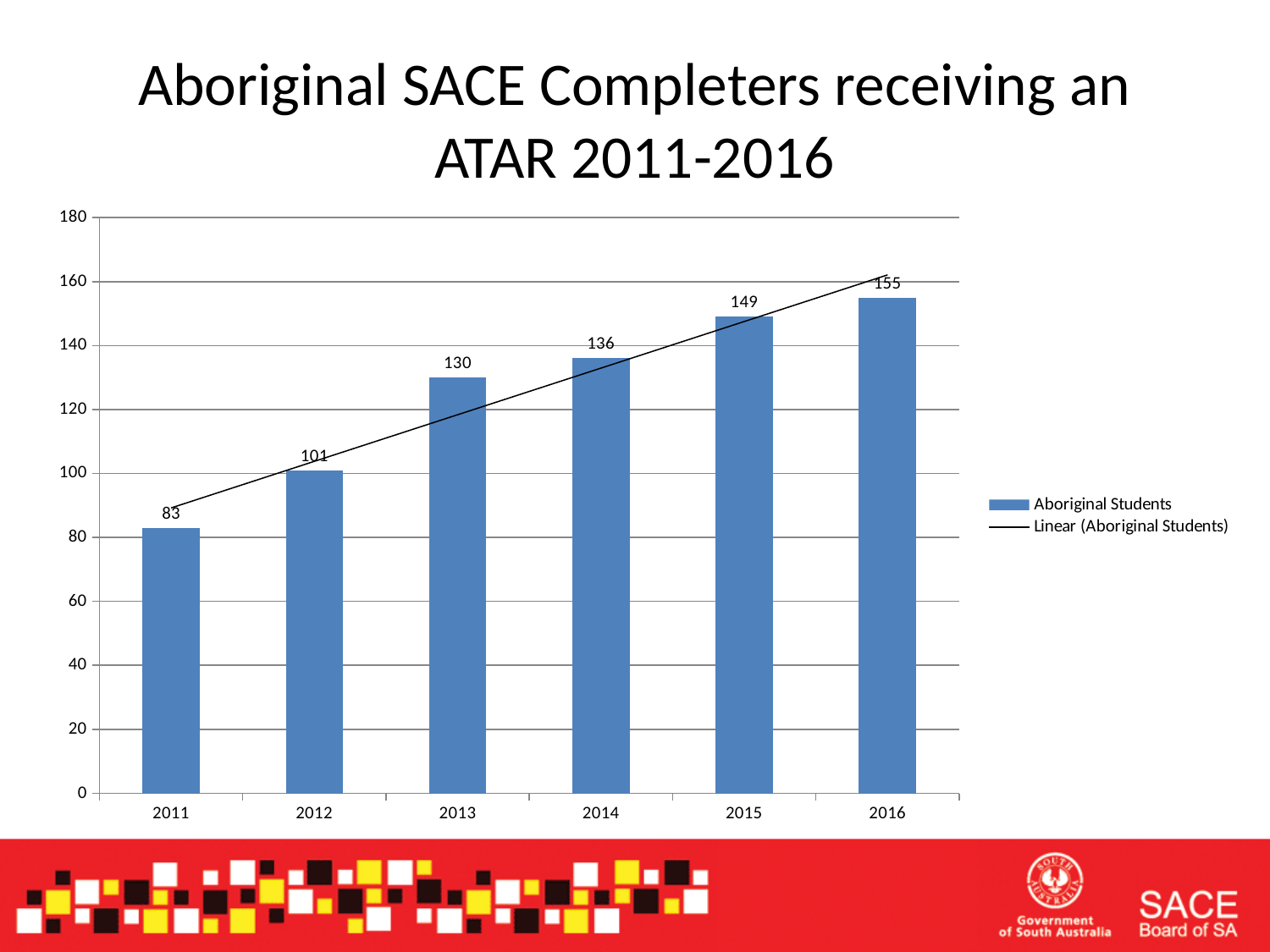
What is the difference between the values for 2016 and 2011? 72 Is the value for 2015 greater or less than 140? greater What is the value for 2016? 155 How many years are shown on the x axis? 6 Which year has the highest value? 2016 What is the difference between the values for 2015 and 2014? 13 How many entries does the legend list? 2 Do the values rise or fall from 2011 to 2016? rise Which is larger, the value for 2012 or the value for 2014? 2014 Which year has the lowest value? 2011 What is the value for 2011? 83 What is the value for 2013? 130